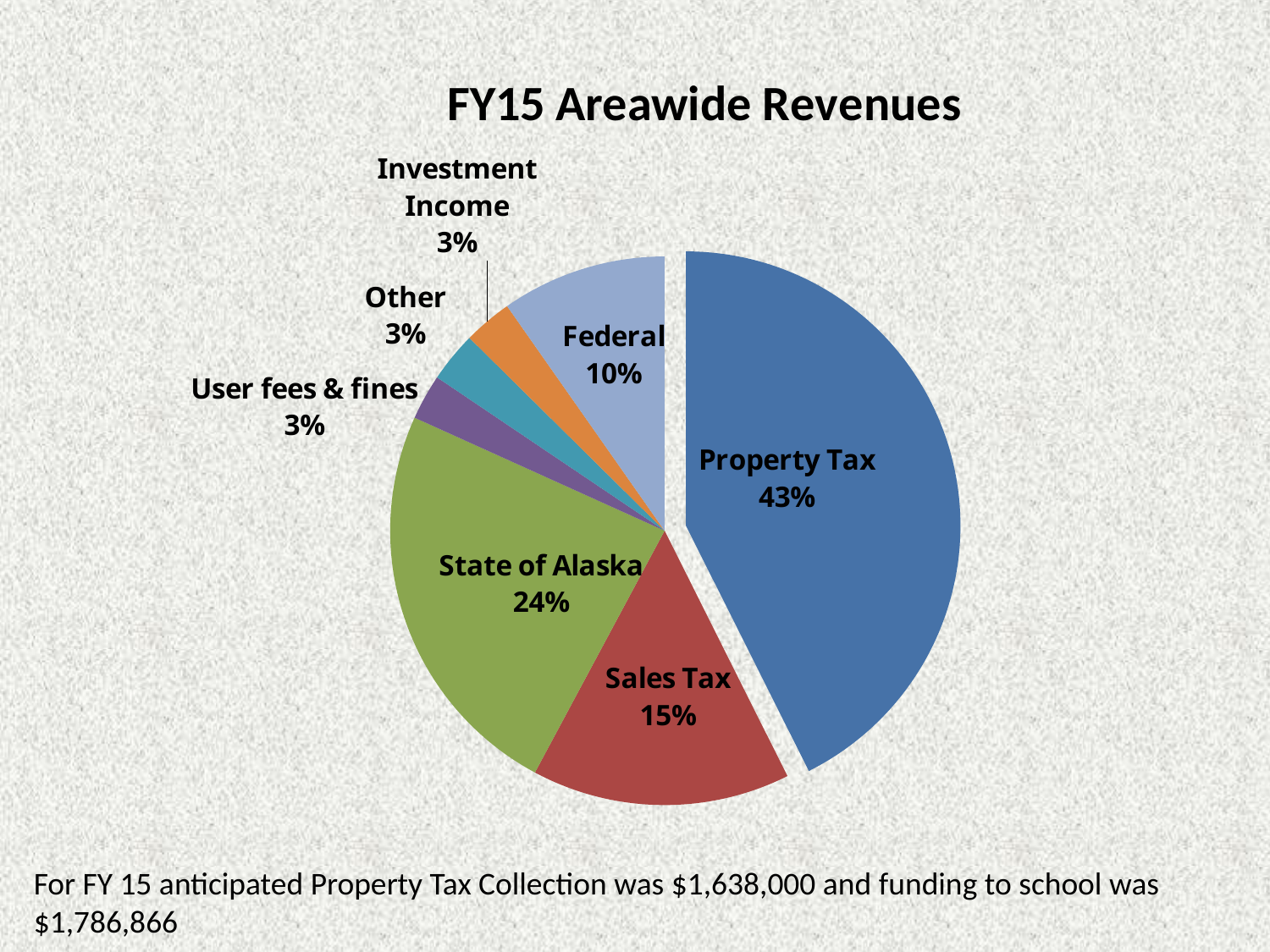
What is the difference in percentage points between Property Tax and State of Alaska? 19 What is the title of the chart? FY15 Areawide Revenues How many revenue categories are shown in the pie chart? 7 What share of FY15 Areawide Revenues comes from Property Tax? 43% What type of chart is shown on the slide? Pie chart Which revenue source has the largest share? Property Tax What share of revenues comes from User fees & fines? 3% What is the Sales Tax share of FY15 Areawide Revenues? 15% Which is larger, the Sales Tax share or the Federal share? Sales Tax What percentage of revenues is Federal? 10% What is the difference in percentage points between Sales Tax and Federal? 5 What percentage of revenues is from the State of Alaska? 24%